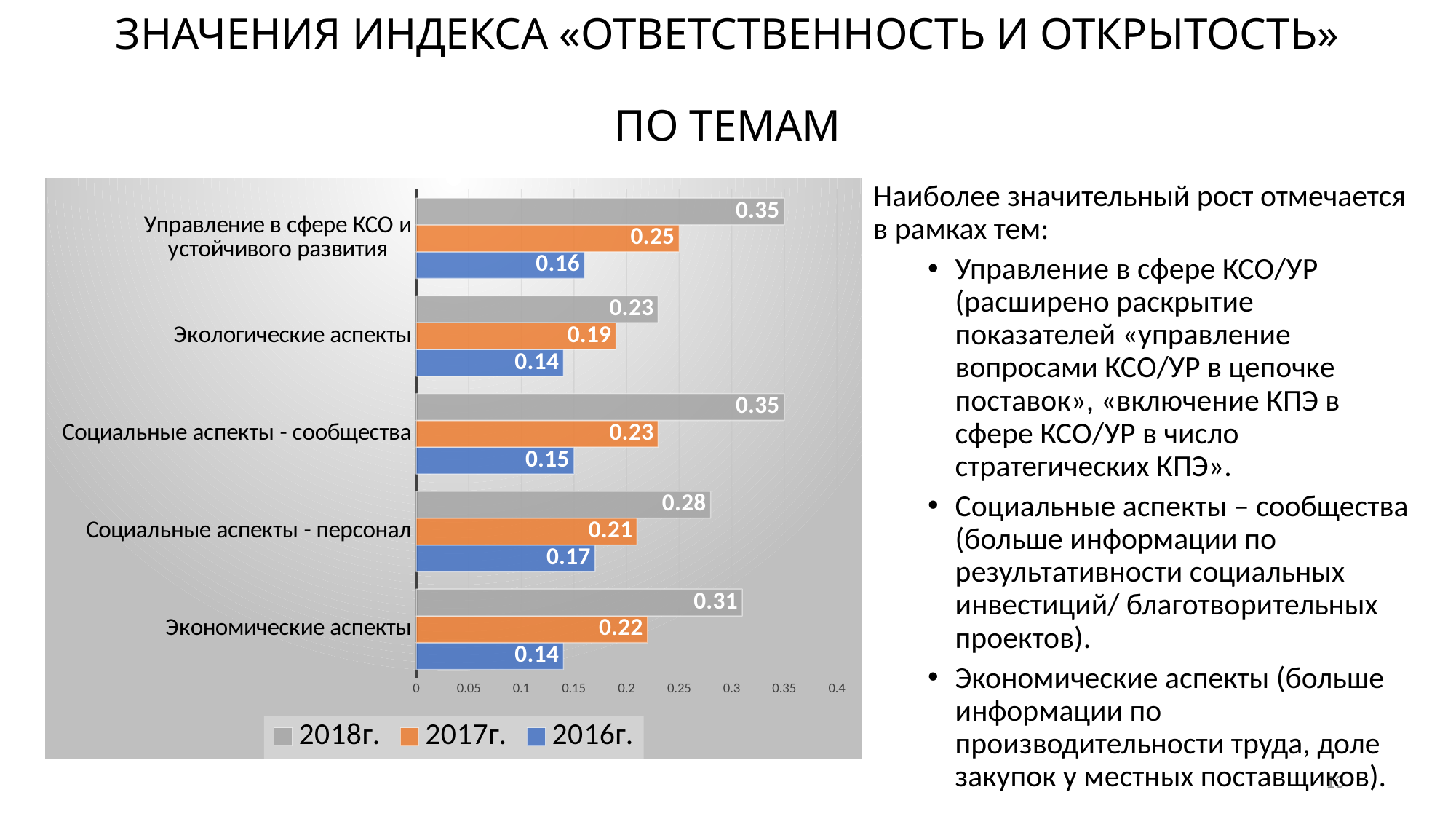
What type of chart is shown on the slide? Bar chart Which is larger: the 2018г. value for Экономические аспекты or the 2018г. value for Социальные аспекты - персонал? Экономические аспекты Which series is shown in orange in the legend? 2017г. What is the difference between the 2018г. and 2016г. values for Управление в сфере КСО и устойчивого развития? 0.19 How many series does the legend list? 3 How many categories are shown on the chart? 5 Which category has the lowest 2018г. value? Экологические аспекты Which category has the highest 2016г. value? Социальные аспекты - персонал What is the 2016г. value for Социальные аспекты - персонал? 0.17 What is the 2018г. value for Экологические аспекты? 0.23 Which category has the highest 2017г. value? Управление в сфере КСО и устойчивого развития What is the 2017г. value for Экономические аспекты? 0.22